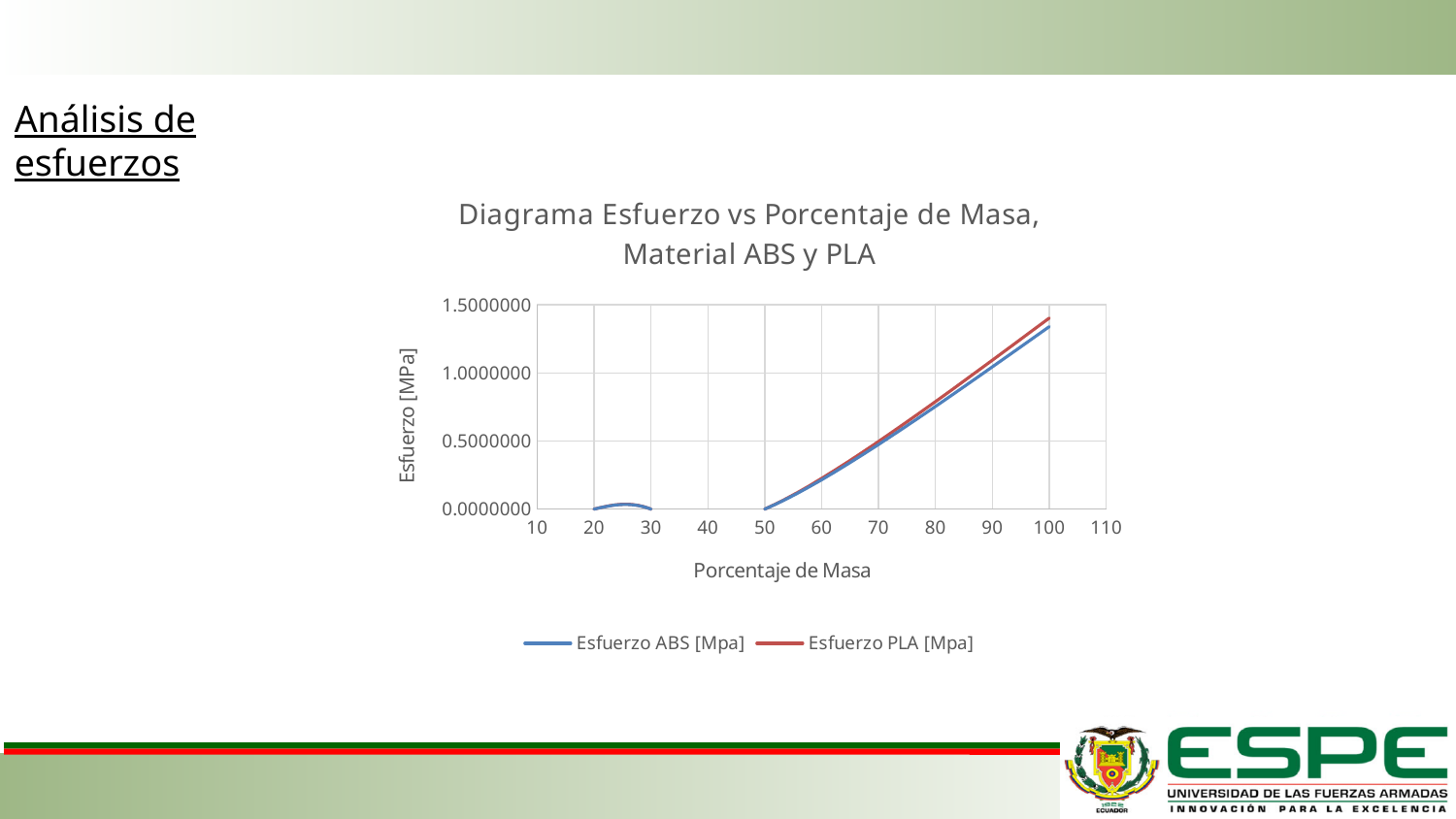
Is the value for Esfuerzo PLA [Mpa] at Porcentaje de Masa 100 greater or less than 1.5000000? less How many series does the legend list? 2 What is the label of the vertical axis? Esfuerzo [MPa] What kind of chart is shown on the slide? Line chart At Porcentaje de Masa 100, which series has the higher value, Esfuerzo ABS [Mpa] or Esfuerzo PLA [Mpa]? Esfuerzo PLA [Mpa] Is the value for Esfuerzo PLA [Mpa] at Porcentaje de Masa 100 greater or less than 1.0000000? greater Is the value for Esfuerzo ABS [Mpa] at Porcentaje de Masa 100 greater or less than 1.0000000? greater What is the title of the chart? Diagrama Esfuerzo vs Porcentaje de Masa, Material ABS y PLA Do the Esfuerzo PLA [Mpa] values rise or fall as Porcentaje de Masa increases from 50 to 100? Rise Do the Esfuerzo ABS [Mpa] values rise or fall as Porcentaje de Masa increases from 50 to 100? Rise